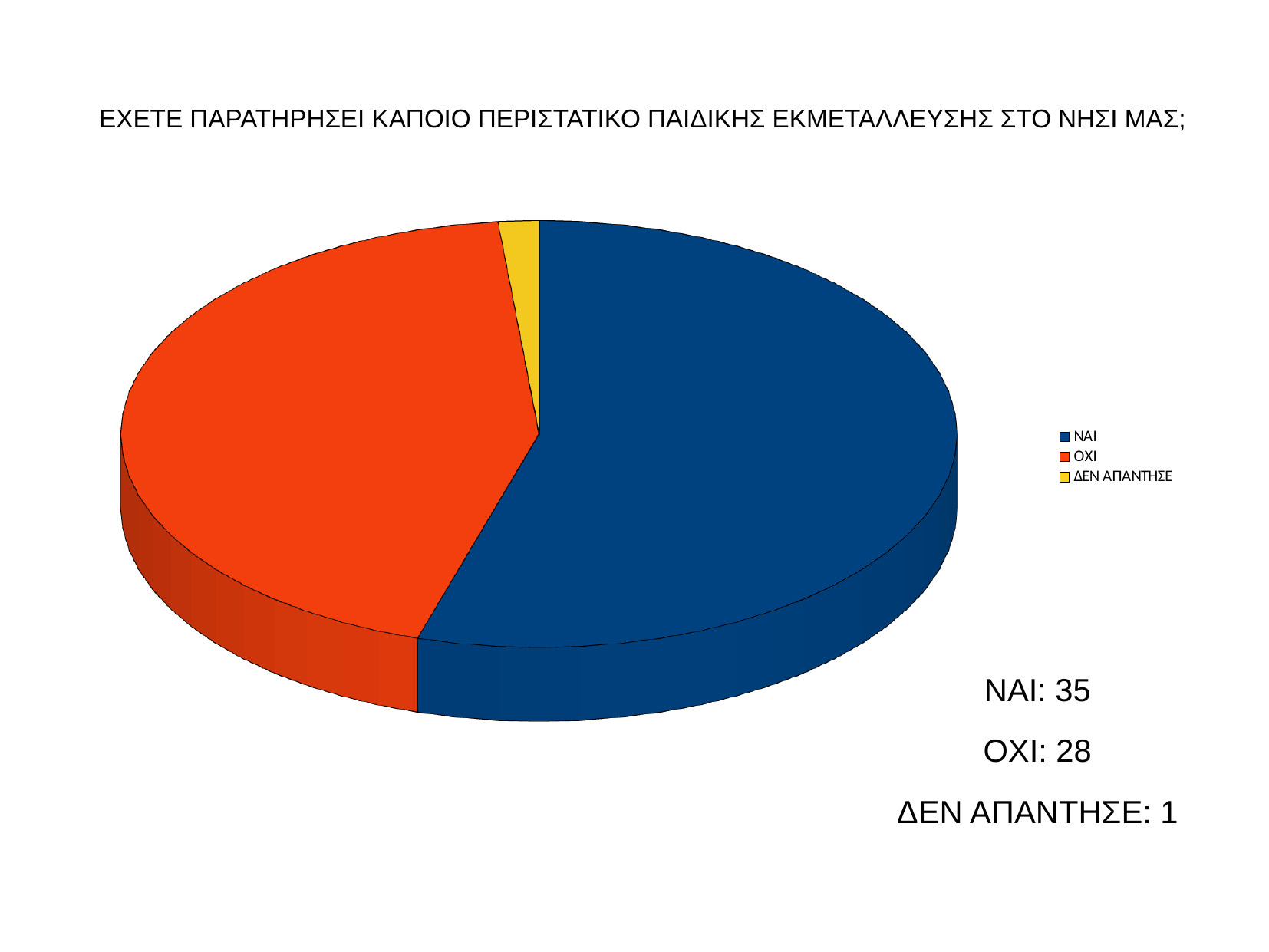
What kind of chart is shown on the slide? pie chart How many categories does the pie chart have? 3 What is the difference between the values for ΝΑΙ and ΟΧΙ? 7 What is the value for ΝΑΙ? 35 Which category has the largest slice of the pie? ΝΑΙ Which is larger, the value for ΝΑΙ or the value for ΟΧΙ? ΝΑΙ Which colour represents ΟΧΙ in the pie chart? red How many entries does the legend list? 3 What is the value for ΔΕΝ ΑΠΑΝΤΗΣΕ? 1 Which category has the smallest slice of the pie? ΔΕΝ ΑΠΑΝΤΗΣΕ What is the value for ΟΧΙ? 28 What is the total of all three categories in the pie chart? 64